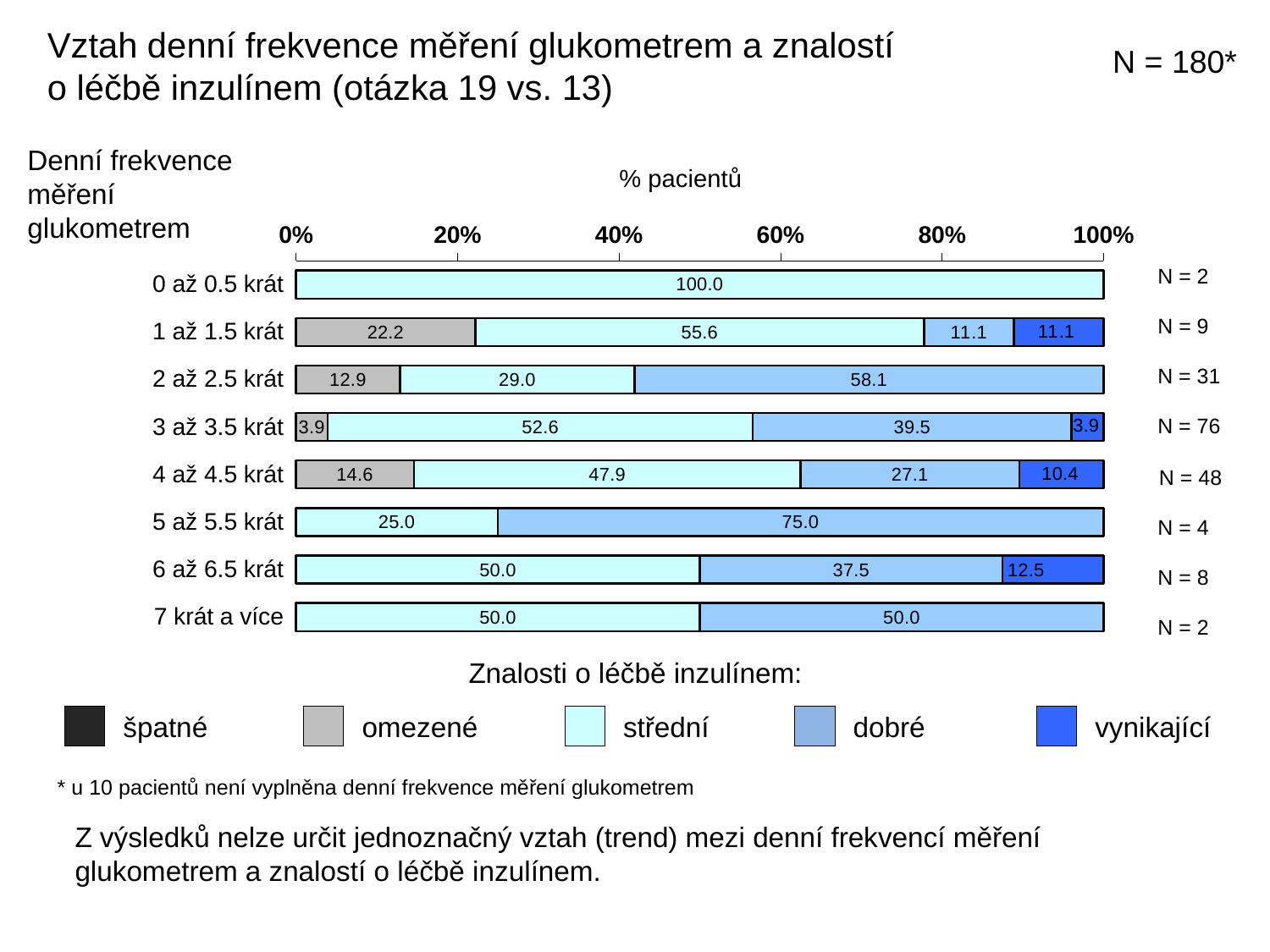
What kind of chart is shown on the slide? Stacked bar chart What is the value of the 'střední' segment for the '3 až 3.5 krát' category? 52.6 What is the value of the 'omezené' segment for the '4 až 4.5 krát' category? 14.6 For the '3 až 3.5 krát' category, what is the difference between the 'střední' and 'dobré' values? 13.1 What is the value of the 'vynikající' segment for the '6 až 6.5 krát' category? 12.5 How many knowledge levels does the legend list? 5 What is the total of the stacked bar for the '2 až 2.5 krát' category? 100.0 How many daily measurement frequency categories are shown on the chart? 8 What is the N value shown next to the '3 až 3.5 krát' bar? N = 76 What is the value of the 'dobré' segment for the '2 až 2.5 krát' category? 58.1 Which category has the highest 'dobré' value? 5 až 5.5 krát Which has the larger 'střední' value: '1 až 1.5 krát' or '4 až 4.5 krát'? 1 až 1.5 krát